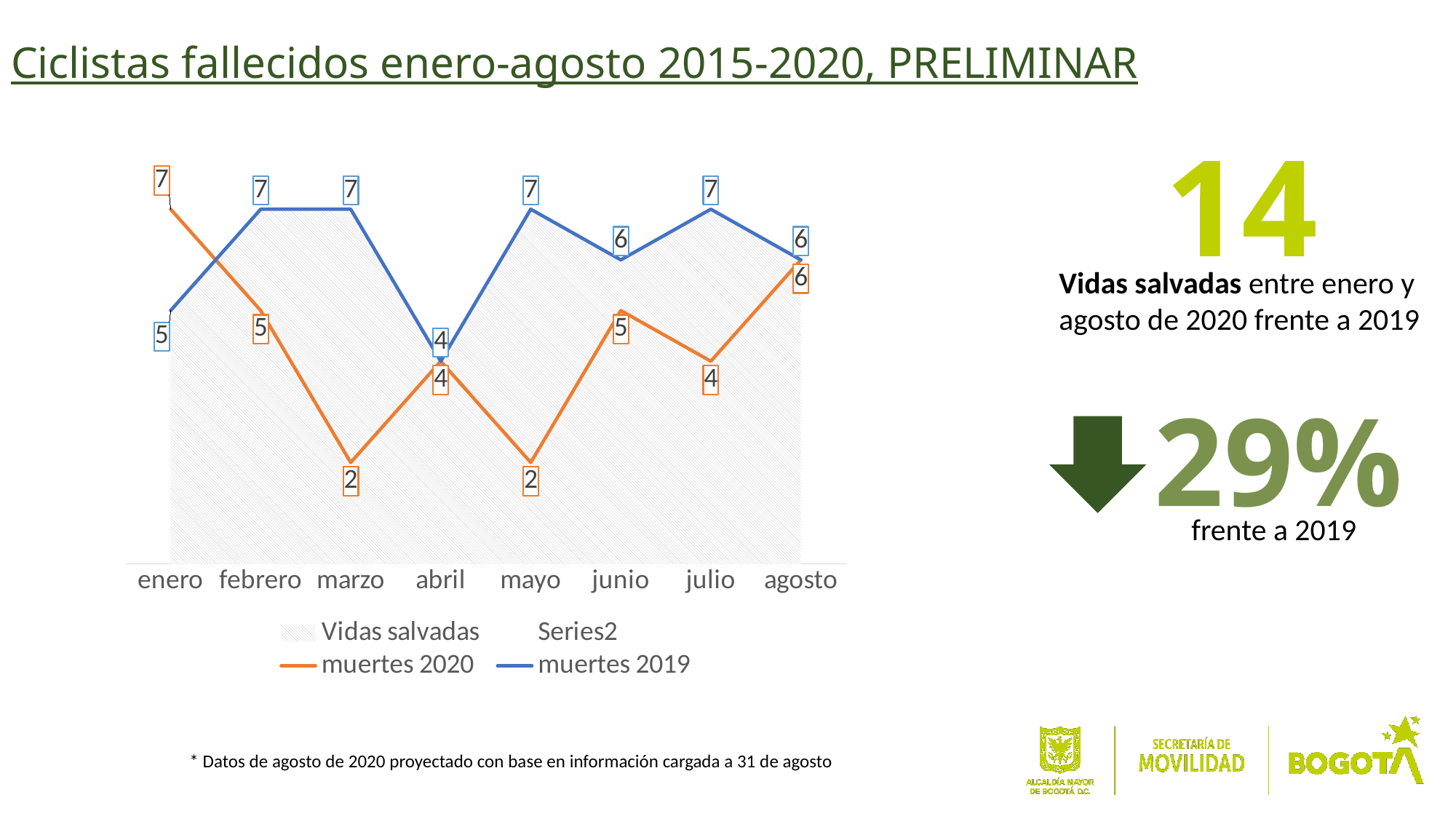
How many entries does the legend list? 4 How many months are shown on the x axis? 8 Does the muertes 2020 line rise or fall from enero to marzo? fall What kind of chart is shown on the slide? line chart Which is larger in enero, muertes 2020 or muertes 2019? muertes 2020 Which colour is used for the muertes 2019 line? blue What is the value for muertes 2019 in abril? 4 What is the value for muertes 2020 in marzo? 2 What is the value for muertes 2020 in enero? 7 What is the value for muertes 2019 in febrero? 7 In which month is the muertes 2019 value lowest? abril What is the difference between muertes 2019 and muertes 2020 in marzo? 5